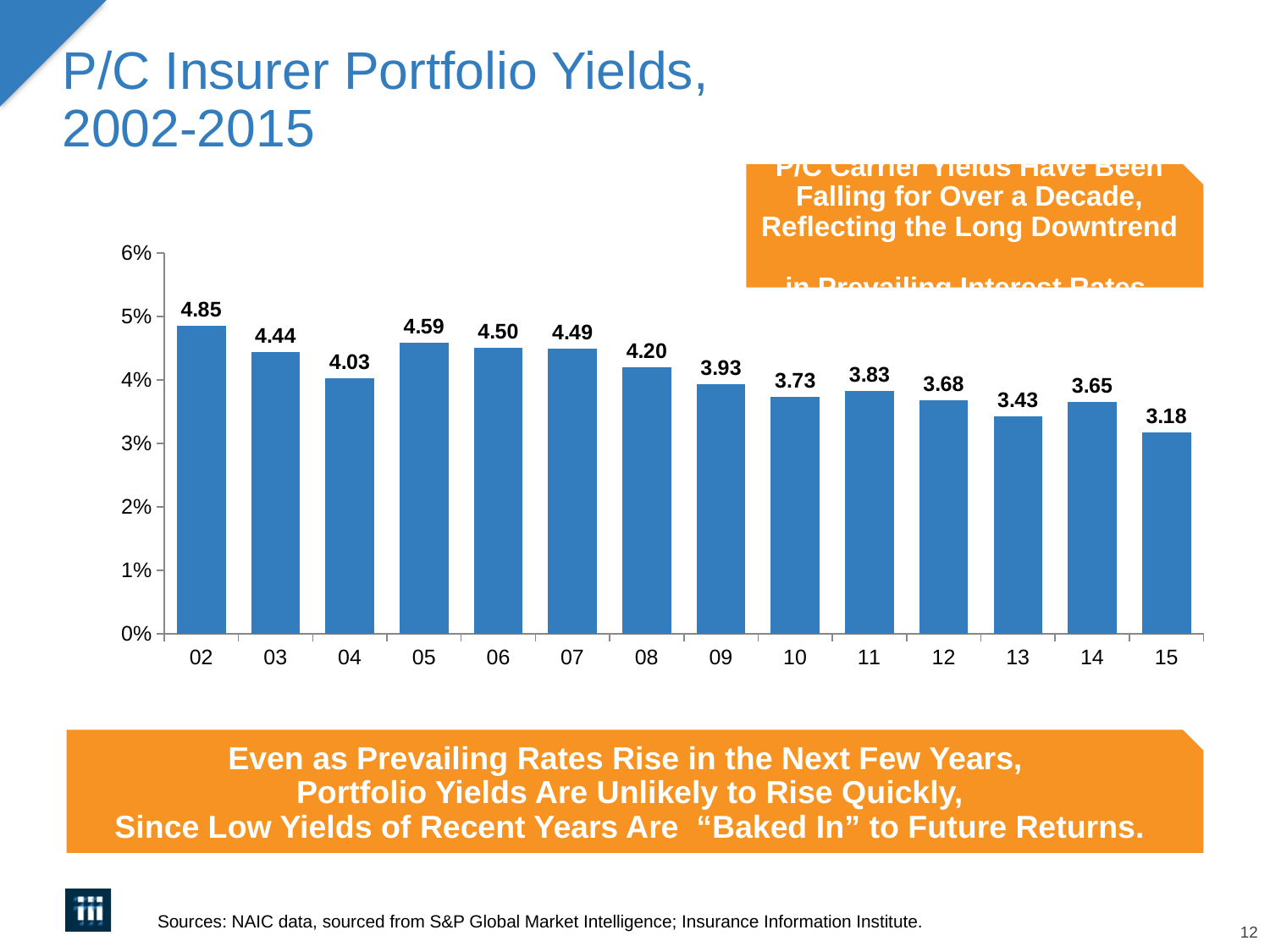
What is the portfolio yield value shown for 09? 3.93 What is the portfolio yield value shown for 15? 3.18 Which year has the highest portfolio yield? 02 How many years are shown on the x axis? 14 What is the difference between the yield in 02 and the yield in 15? 1.67 Which year has a higher yield, 11 or 13? 11 Do the portfolio yields generally rise or fall from 02 to 15? Fall What is the portfolio yield value shown for 02? 4.85 Is the value for 08 greater or less than 4%? greater What is the title of the slide? P/C Insurer Portfolio Yields, 2002-2015 Which year has the lowest portfolio yield? 15 What kind of chart is shown on the slide? Bar chart